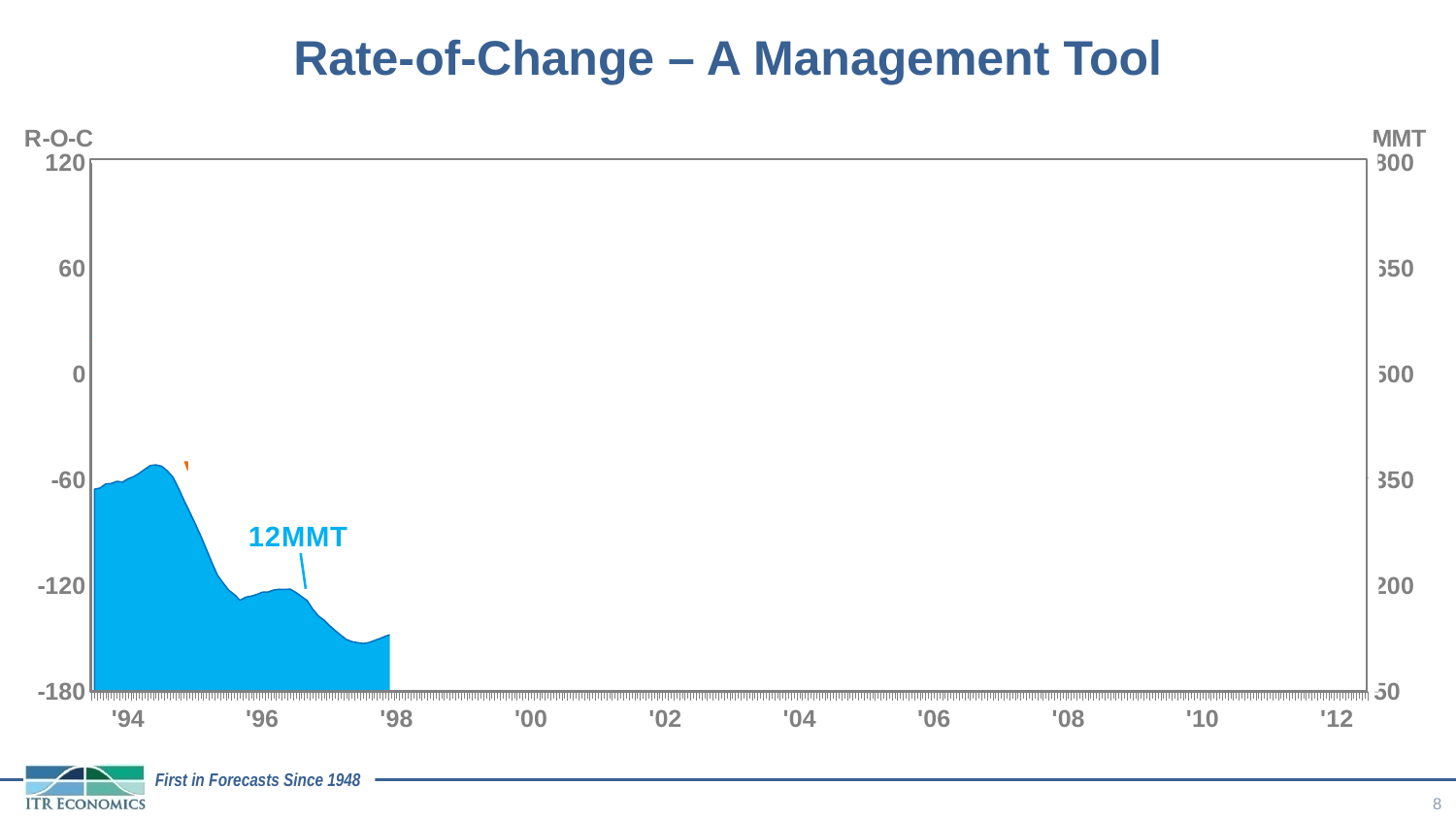
Which is larger for the 12MMT series, the value at '94 or the value at '98? '94 How many data series are plotted on the chart? 1 What is the lowest value shown on the left (R-O-C) axis of the chart? -180 What label is given to the plotted series on the chart? 12MMT What is the first year label on the x axis of the chart? '94 What is the highest value shown on the left (R-O-C) axis of the chart? 120 What kind of chart is shown on the slide? area chart Does the 12MMT series rise or fall overall from '94 to '98? fall What is the title of the chart on the slide? Rate-of-Change – A Management Tool How many year labels are shown along the x axis of the chart? 10 What is the last year label on the x axis of the chart? '12